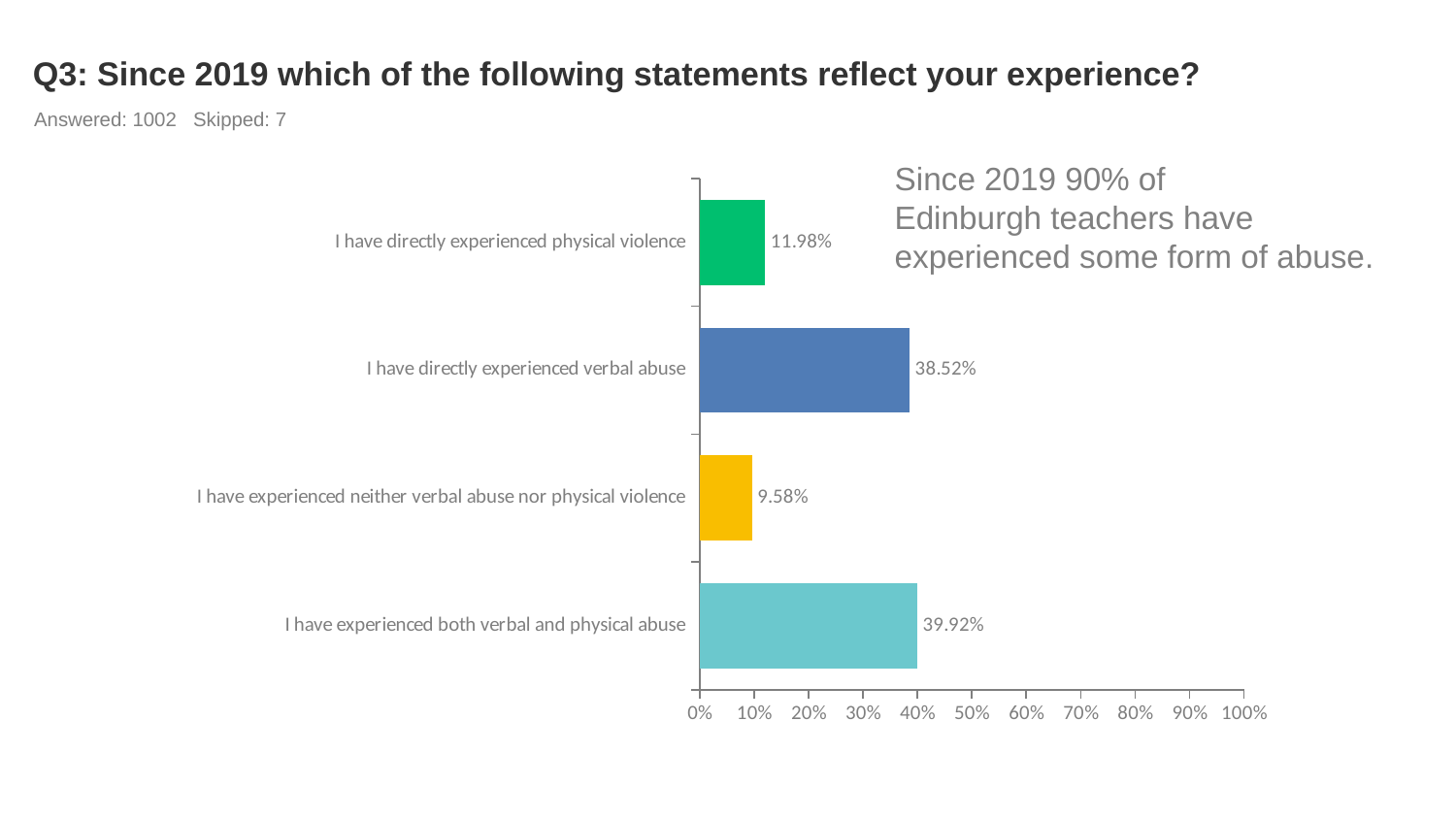
What percentage of respondents said they have directly experienced physical violence? 11.98% What percentage of respondents said they have experienced neither verbal abuse nor physical violence? 9.58% Is the value for 'I have directly experienced verbal abuse' greater or less than 30%? greater What percentage of respondents said they have directly experienced verbal abuse? 38.52% What is the difference in percentage points between 'I have directly experienced verbal abuse' and 'I have directly experienced physical violence'? 26.54 What kind of chart is shown on the slide? Bar chart Which statement has the highest percentage of respondents? I have experienced both verbal and physical abuse How many respondents answered the question according to the slide? 1002 How many statements (categories) are shown in the chart? 4 Which is larger: the percentage for 'I have directly experienced physical violence' or for 'I have experienced neither verbal abuse nor physical violence'? I have directly experienced physical violence What percentage of respondents said they have experienced both verbal and physical abuse? 39.92% Which statement has the lowest percentage of respondents? I have experienced neither verbal abuse nor physical violence